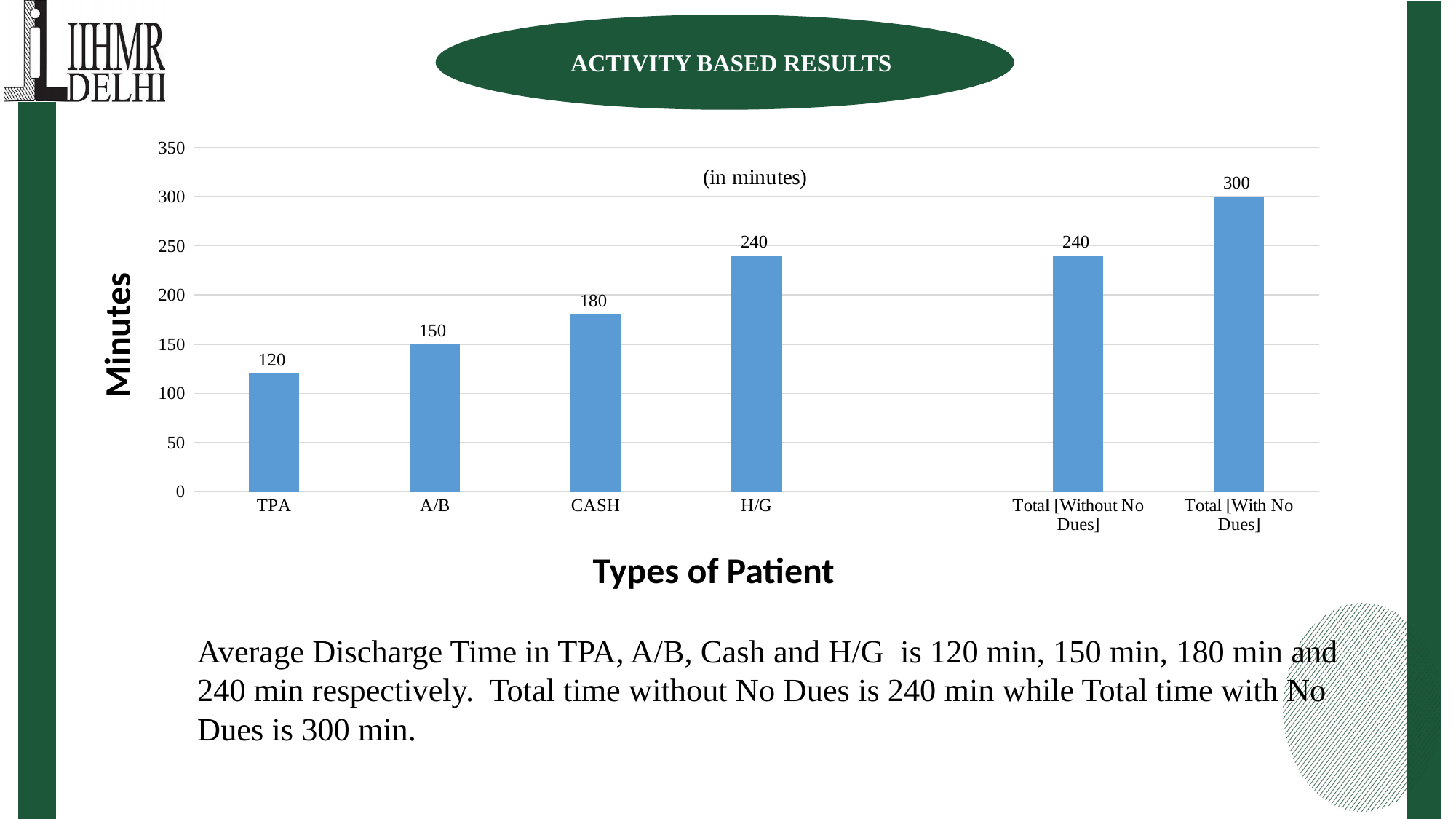
Which category has the lowest value? TPA What is the value for TPA? 120 What is the value for Total [With No Dues]? 300 What is the difference between the values for H/G and A/B? 90 What is the difference between Total [With No Dues] and Total [Without No Dues]? 60 Do the values rise or fall from TPA to H/G along the x axis? Rise What kind of chart is shown on the slide? Bar chart What is the label of the y axis? Minutes What is the value for CASH? 180 How many categories are shown on the x axis? 6 Which category has the highest value? Total [With No Dues] Which is larger, the value for CASH or the value for A/B? CASH